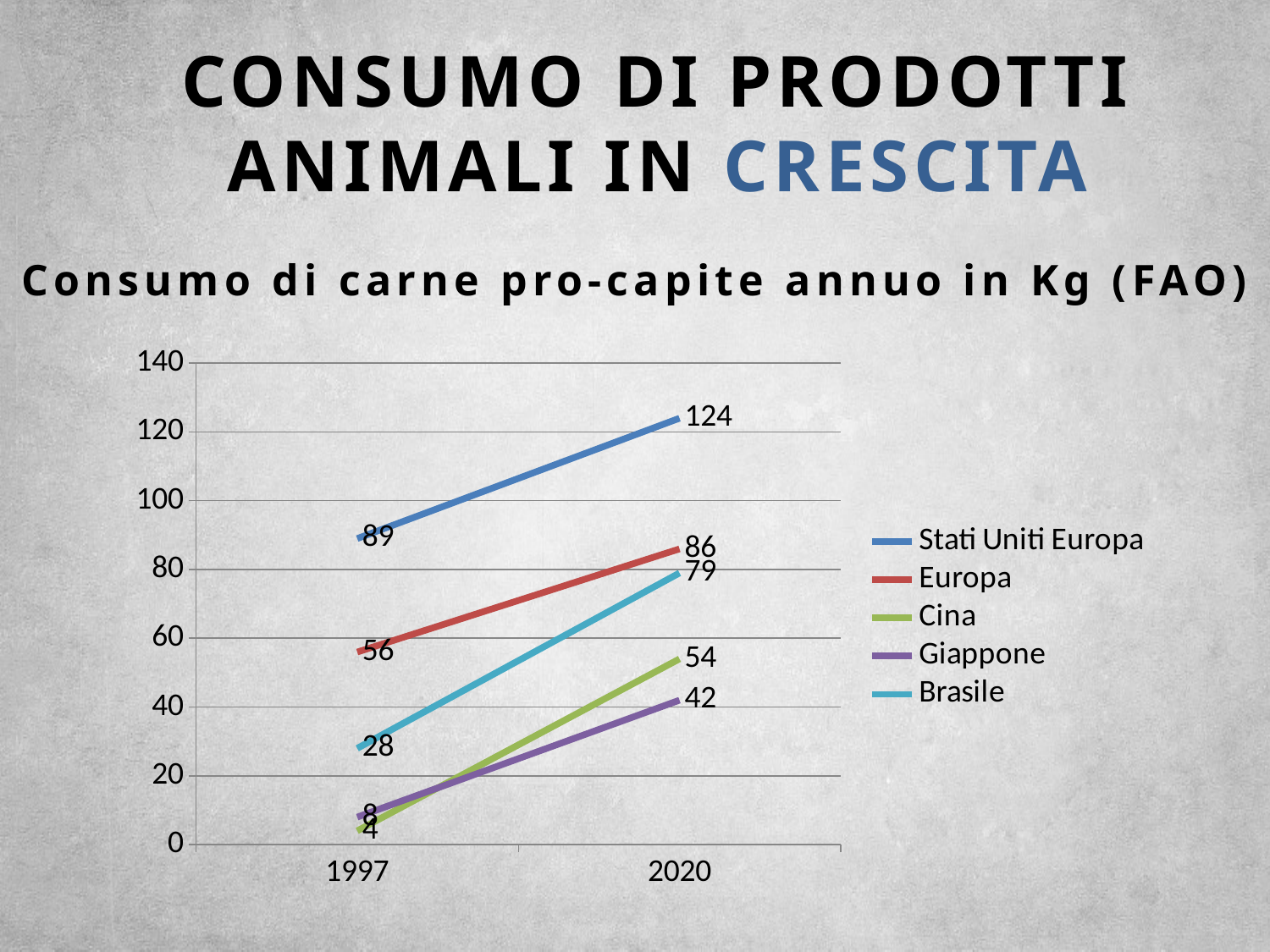
What is the value for Europa in 1997? 56 By how much did the value for Stati Uniti Europa increase from 1997 to 2020? 35 What is the value for Brasile in 2020? 79 How many series does the legend list? 5 What kind of chart is shown on the slide? line chart In 2020, which is larger: the value for Europa or the value for Brasile? Europa What is the value for Cina in 2020? 54 Does the value for Brasile rise or fall from 1997 to 2020? rise Which series has the highest value in 2020? Stati Uniti Europa How many years are shown on the x axis? 2 What is the value for Stati Uniti Europa in 2020? 124 Which series has the lowest value in 2020? Giappone